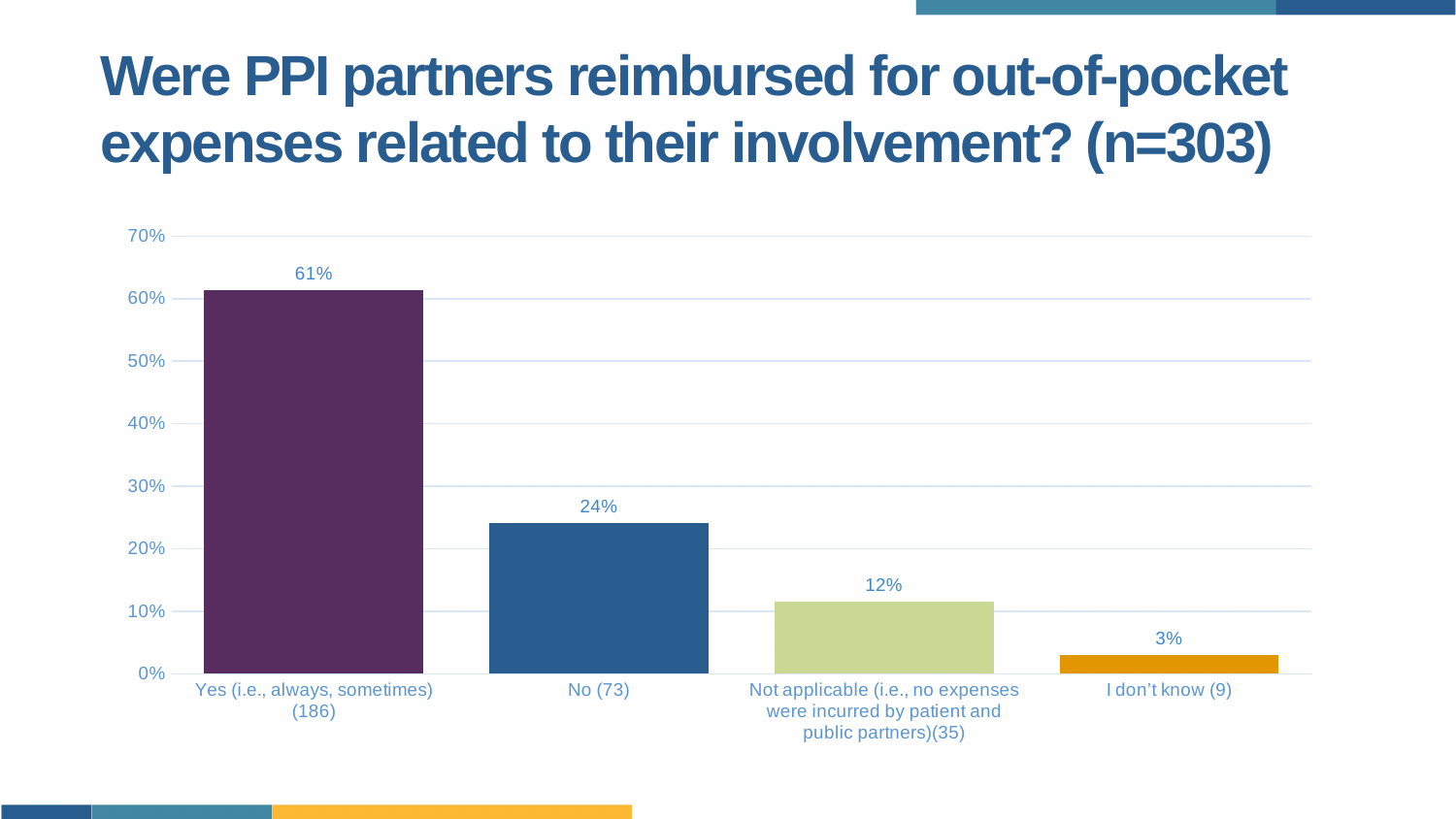
What percentage of respondents answered "No"? 24% How many respondents answered "No"? 73 What percentage of respondents answered "Yes (i.e., always, sometimes)"? 61% What percentage of respondents answered "Not applicable"? 12% Which is larger, the percentage for "No" or for "Not applicable"? No What percentage of respondents answered "I don't know"? 3% What type of chart is shown on the slide? Bar chart What is the total number of respondents (n) given in the slide title? 303 Which response category has the highest percentage? Yes (i.e., always, sometimes) How many response categories are shown in the chart? 4 Which response category has the lowest percentage? I don't know What is the difference in percentage points between the "Yes" and "No" categories? 37 percentage points